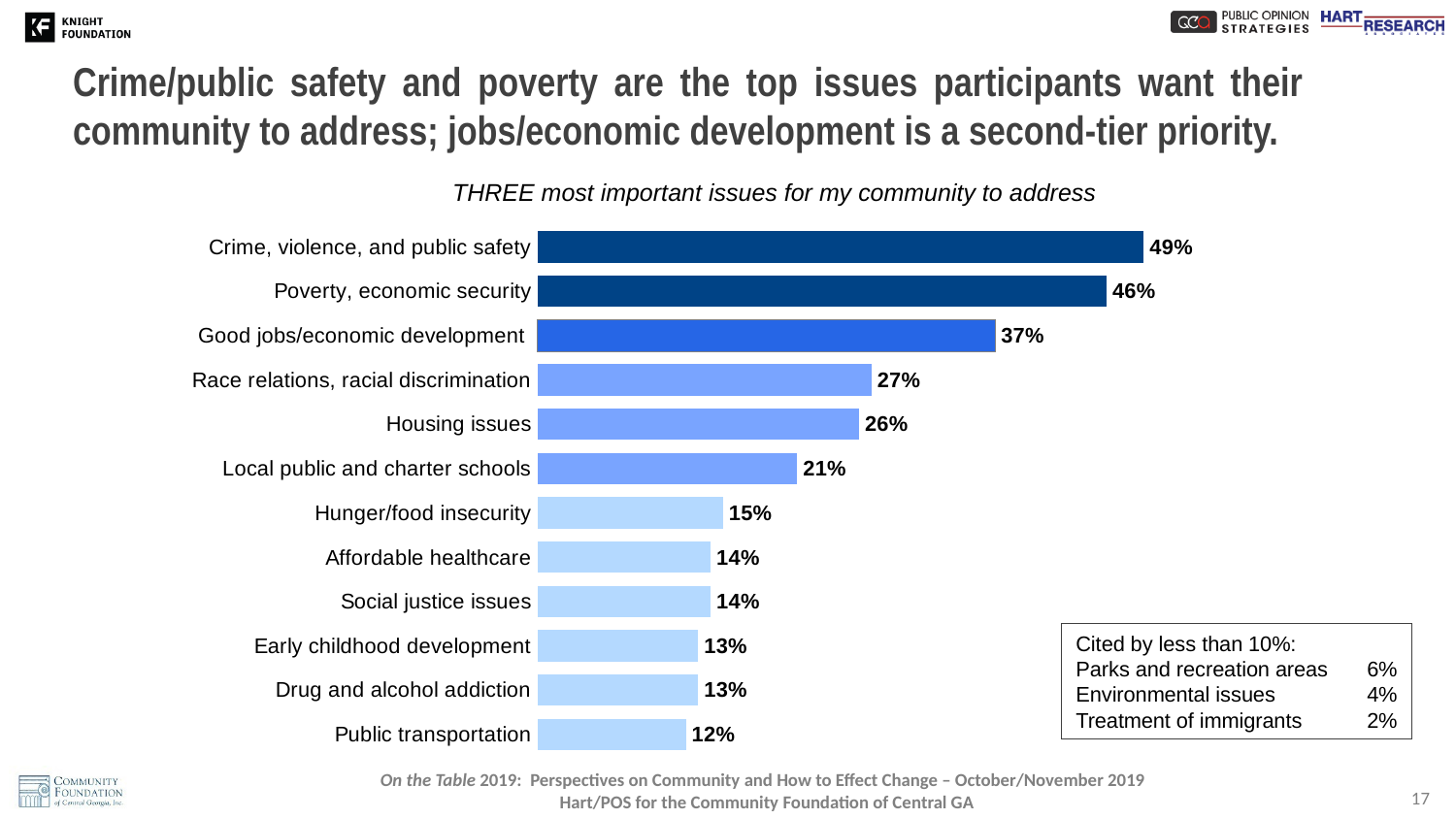
What is the value shown for housing issues? 26% According to the text box, what percentage cited environmental issues? 4% What percentage of participants cited crime, violence, and public safety as one of the three most important issues? 49% What is the title of the chart? THREE most important issues for my community to address What is the difference in percentage points between hunger/food insecurity and affordable healthcare? 1 Which has a higher value: race relations, racial discrimination or local public and charter schools? Race relations, racial discrimination How many issues are plotted as bars in the chart? 12 What percentage is shown for public transportation? 12% What is the difference in percentage points between poverty, economic security and good jobs/economic development? 9 What type of chart is shown on the slide? Bar chart Which issue has the lowest percentage among the bars plotted in the chart? Public transportation Which issue has the highest percentage in the chart? Crime, violence, and public safety